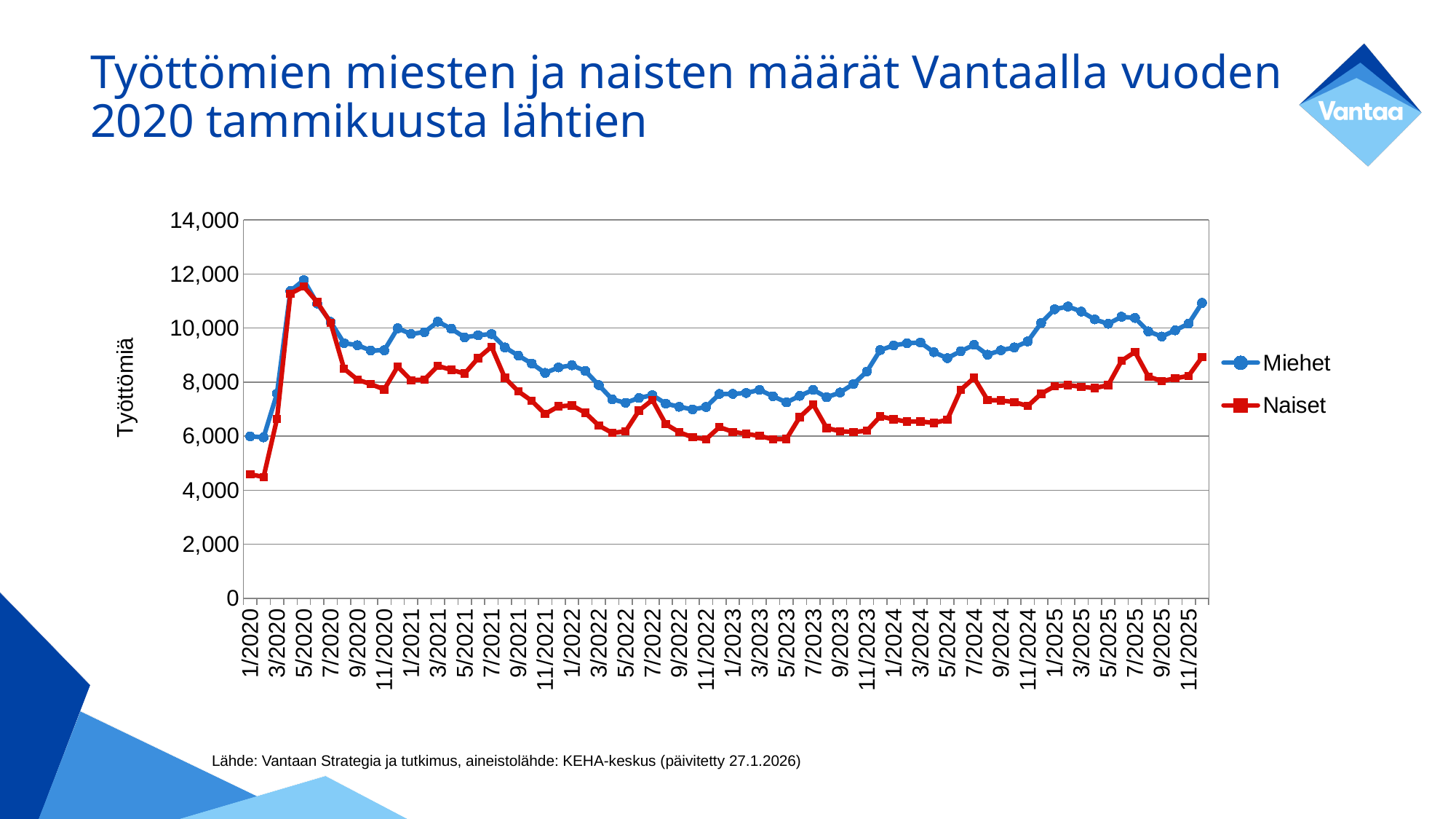
Is the value for Naiset in 1/2020 greater or less than 6,000? less In which month does the Miehet series reach its highest value? 5/2020 How many series does the legend list? 2 Is the value for Miehet in 5/2020 greater or less than 10,000? greater Is the value for Naiset in 3/2022 greater or less than 8,000? less In which month does the Naiset series reach its highest value? 5/2020 In 1/2024, which series has the higher value, Miehet or Naiset? Miehet What kind of chart is shown on the slide? line chart What are the two series named in the legend? Miehet and Naiset What is the label on the vertical axis? Työttömiä Between 5/2020 and 9/2020, does the Miehet series rise or fall? fall